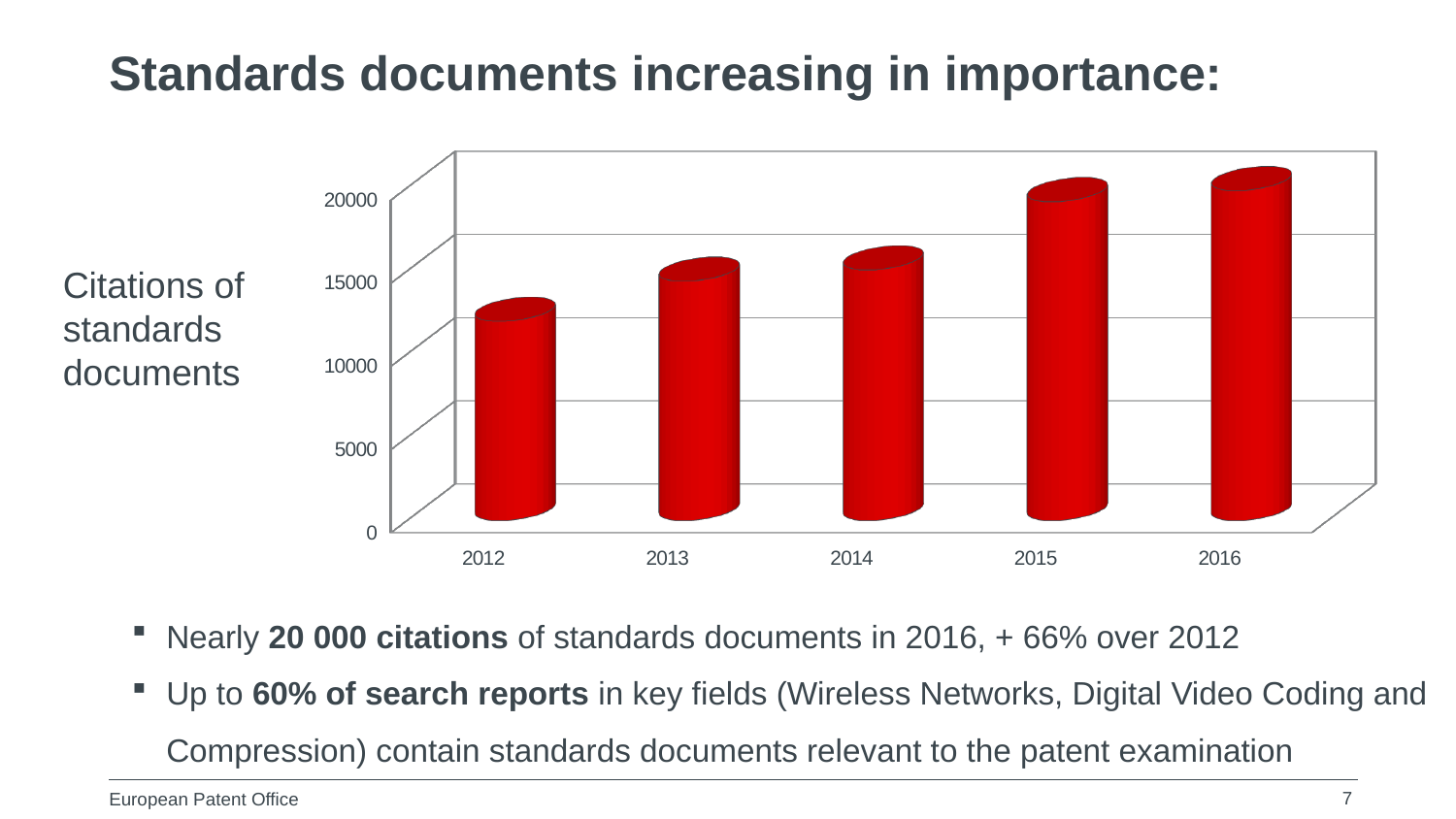
How many years are plotted on the x axis of the chart? 5 Is the value for 2012 greater or less than 15000? less Is the value for 2016 greater or less than 15000? greater Do the citations of standards documents rise or fall from 2012 to 2016? rise Which year has the larger value, 2013 or 2015? 2015 Is the value for 2013 greater or less than 20000? less What kind of chart is shown on the slide? bar chart Which year has the larger value, 2012 or 2014? 2014 Which year has the lowest number of citations of standards documents? 2012 What colour are the bars in the chart? red